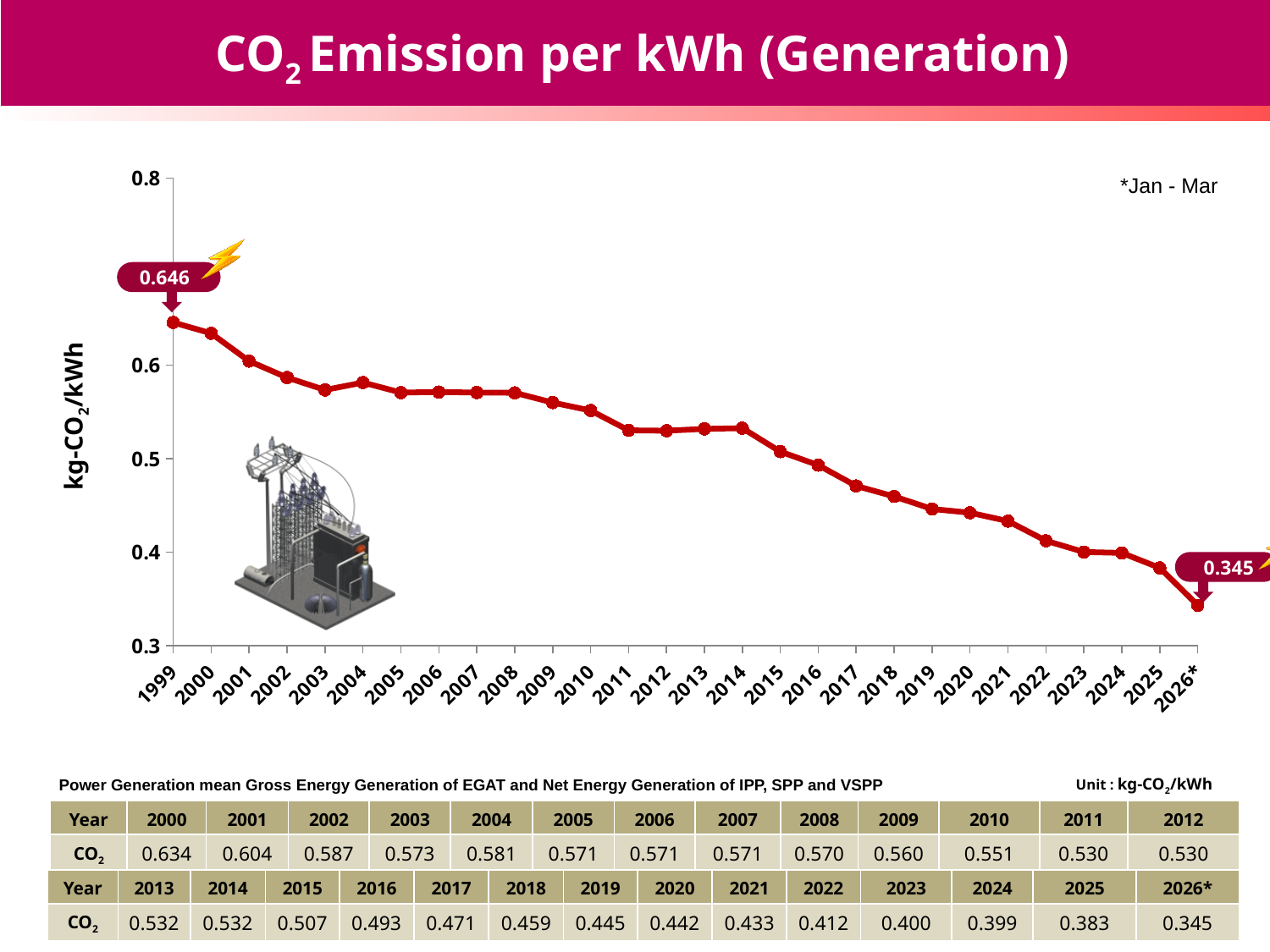
Which year has the lowest CO2 emission per kWh? 2026* What is the CO2 emission per kWh value shown for 1999? 0.646 What kind of chart is shown on the slide? line chart What is the difference between the 1999 value (0.646) and the 2026* value (0.345)? 0.301 What unit is shown on the y axis of the chart? kg-CO2/kWh Is the value for 2015 greater or less than 0.5? greater Which is larger, the value for 2005 or the value for 2020? 2005 Is the value for 2022 greater or less than 0.5? less What is the CO2 emission per kWh value shown for 2026*? 0.345 Do the values generally rise or fall from 1999 to 2026*? fall How many years are plotted on the x axis? 28 Which year has the highest CO2 emission per kWh? 1999